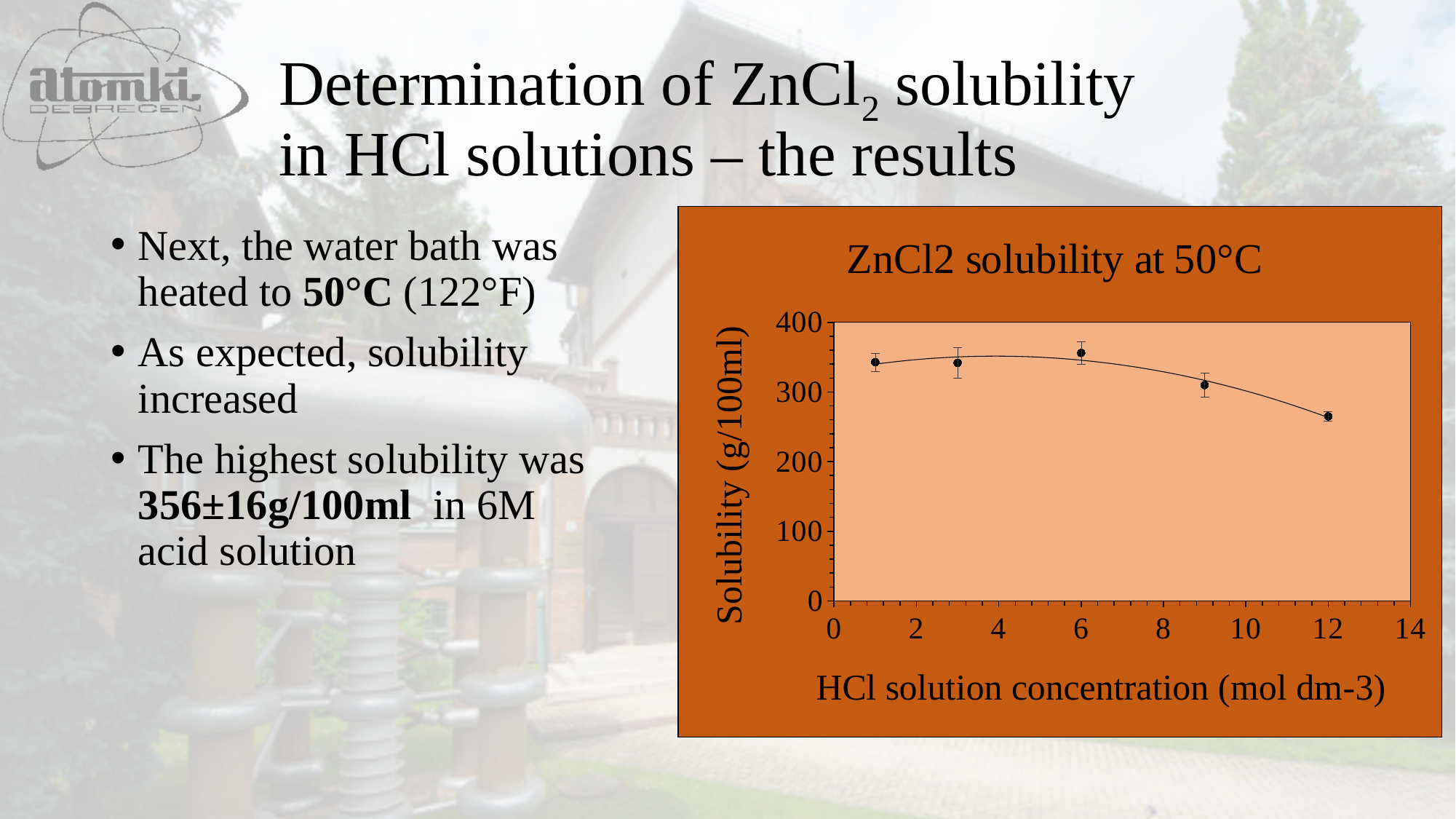
Is the solubility at 6 mol dm-3 HCl greater or less than 300? greater Which has the higher solubility: 6 mol dm-3 HCl or 12 mol dm-3 HCl? 6 mol dm-3 At which HCl concentration is the solubility lowest? 12 Is the solubility at 1 mol dm-3 HCl greater or less than 300? greater Is the solubility at 12 mol dm-3 HCl greater or less than 200? greater What is the title of the chart? ZnCl2 solubility at 50°C How many data points are plotted on the chart? 5 Does the solubility rise or fall between 6 and 12 mol dm-3 HCl? fall What kind of chart is shown on the slide? scatter chart with a trend line What is the label of the y axis of the chart? Solubility (g/100ml) At which HCl concentration is the solubility highest? 6